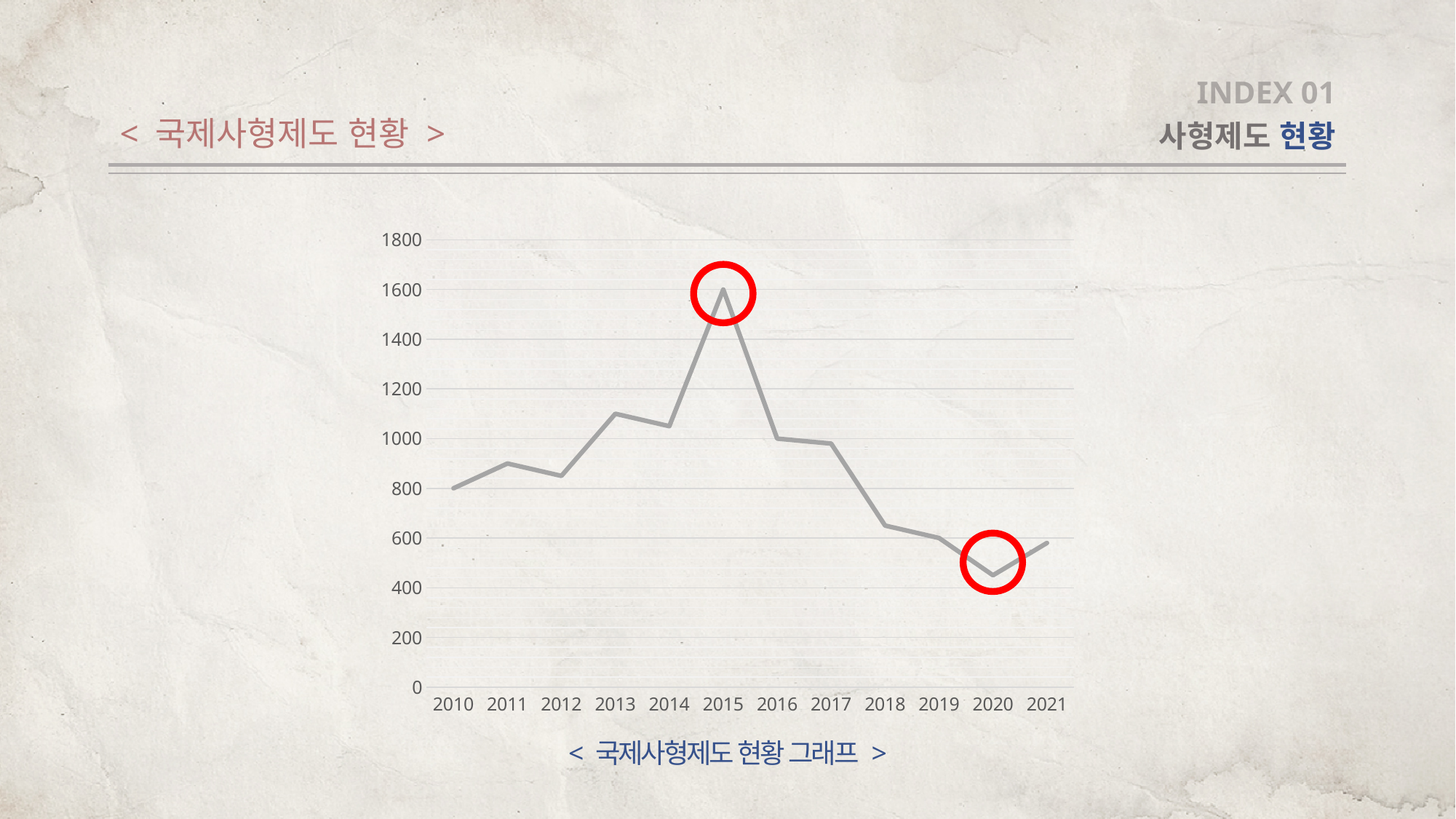
Which year has the lowest value in the chart? 2020 Which year has the highest value in the chart? 2015 Is the value for 2020 greater or less than 600? less Is the value for 2018 greater or less than 800? less What kind of chart is shown on the slide? line chart Which year has the larger value, 2016 or 2019? 2016 Which two years are highlighted with red circles on the chart? 2015 and 2020 How many years are plotted along the x axis of the chart? 12 Is the value for 2013 greater or less than 1000? greater Do the values generally rise or fall from 2015 to 2020? fall What is the value for 2015 in the chart? 1600